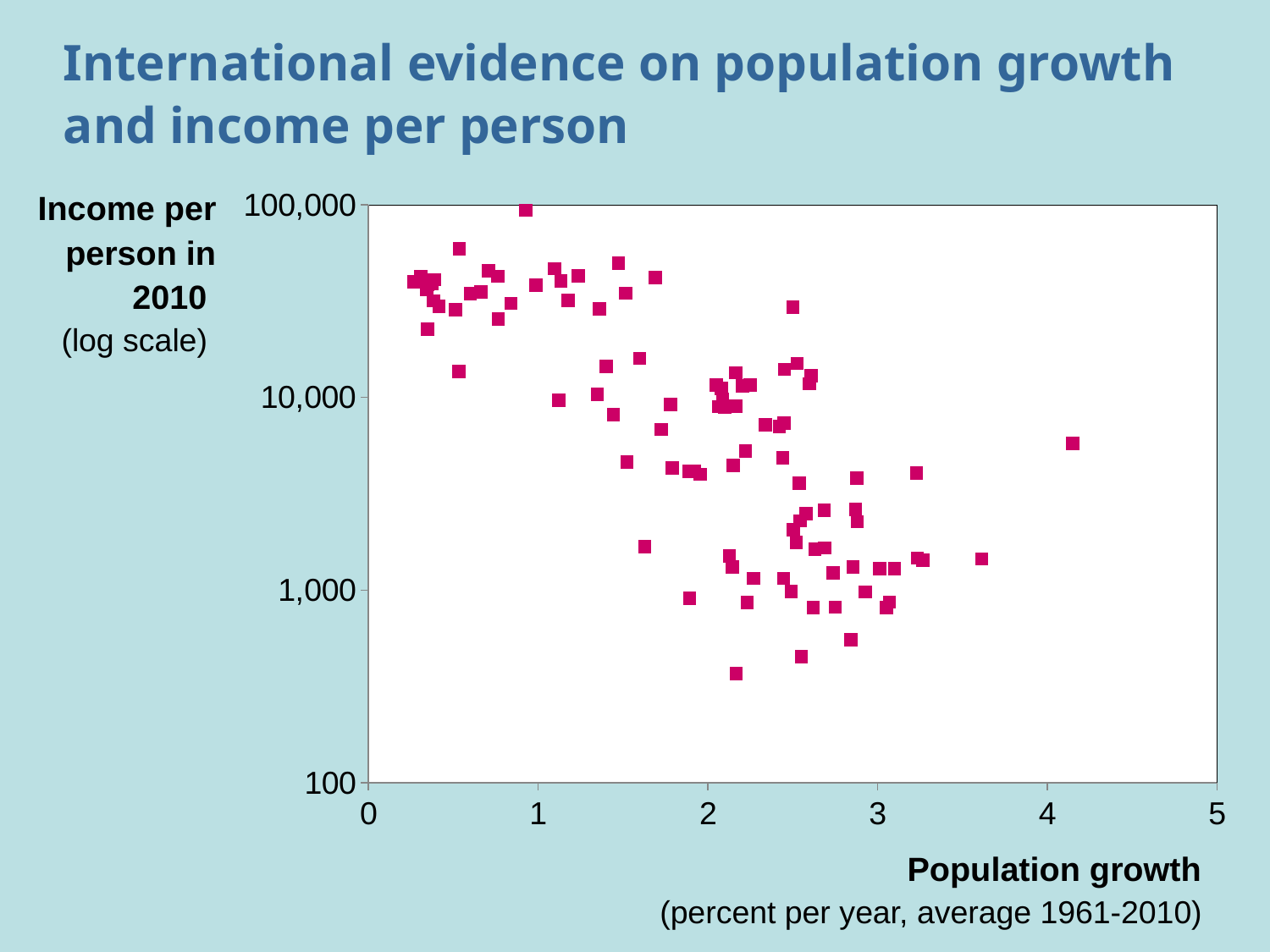
Is the income per person of the point with the highest population growth (around 4 percent) greater or less than 10,000? less What variable is plotted on the horizontal axis? Population growth (percent per year, average 1961-2010) What is the title of the slide's chart? International evidence on population growth and income per person Is the population growth of the point with the highest income per person greater or less than 2? less What kind of chart is shown on the slide? Scatter plot What is the highest value shown on the horizontal axis? 5 Is the income per person of the lowest point on the chart greater or less than 1,000? less As population growth increases along the x axis, does income per person tend to rise or fall? Fall